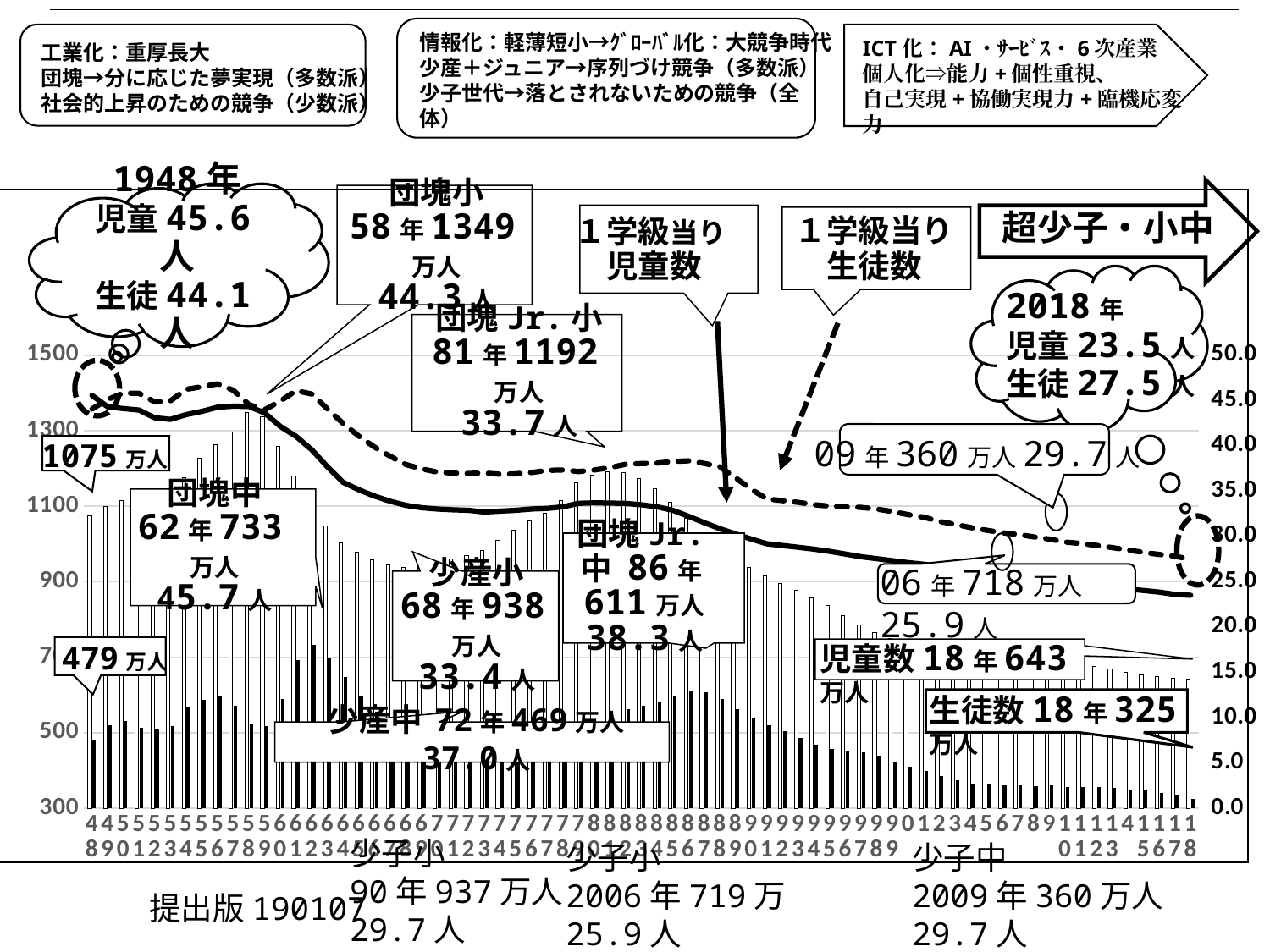
According to the annotation, how many junior high students (生徒数) were there in 1962 (団塊中 62年)? 733万人 In 1948, which was larger: pupils per class (児童 45.6人) or students per class (生徒 44.1人)? 児童 (45.6人) What was the number of students per class (1学級当り生徒数) in 2018? 27.5人 What was the number of pupils per class (1学級当り児童数) in 1948? 45.6人 What is the junior high student count (生徒数) shown for 2018 (18年)? 325万人 What is the difference between the 団塊小 peak (1349万人) and the 団塊Jr.小 peak (1192万人)? 157万人 What is the difference between the 2018 elementary pupil count (643万人) and the 2018 junior high student count (325万人)? 318万人 Does the pupils-per-class line (1学級当り児童数) rise or fall from 1948 to 2018? Fall What kind of chart is shown on the slide? Combined bar and line chart What is the elementary pupil count (児童数) shown for 2018 (18年)? 643万人 In which year does the annotated peak of elementary pupils (団塊小) occur? 1958年 (58年) According to the annotation, how many elementary pupils (児童数) were there in 1958 (団塊小 58年)? 1349万人